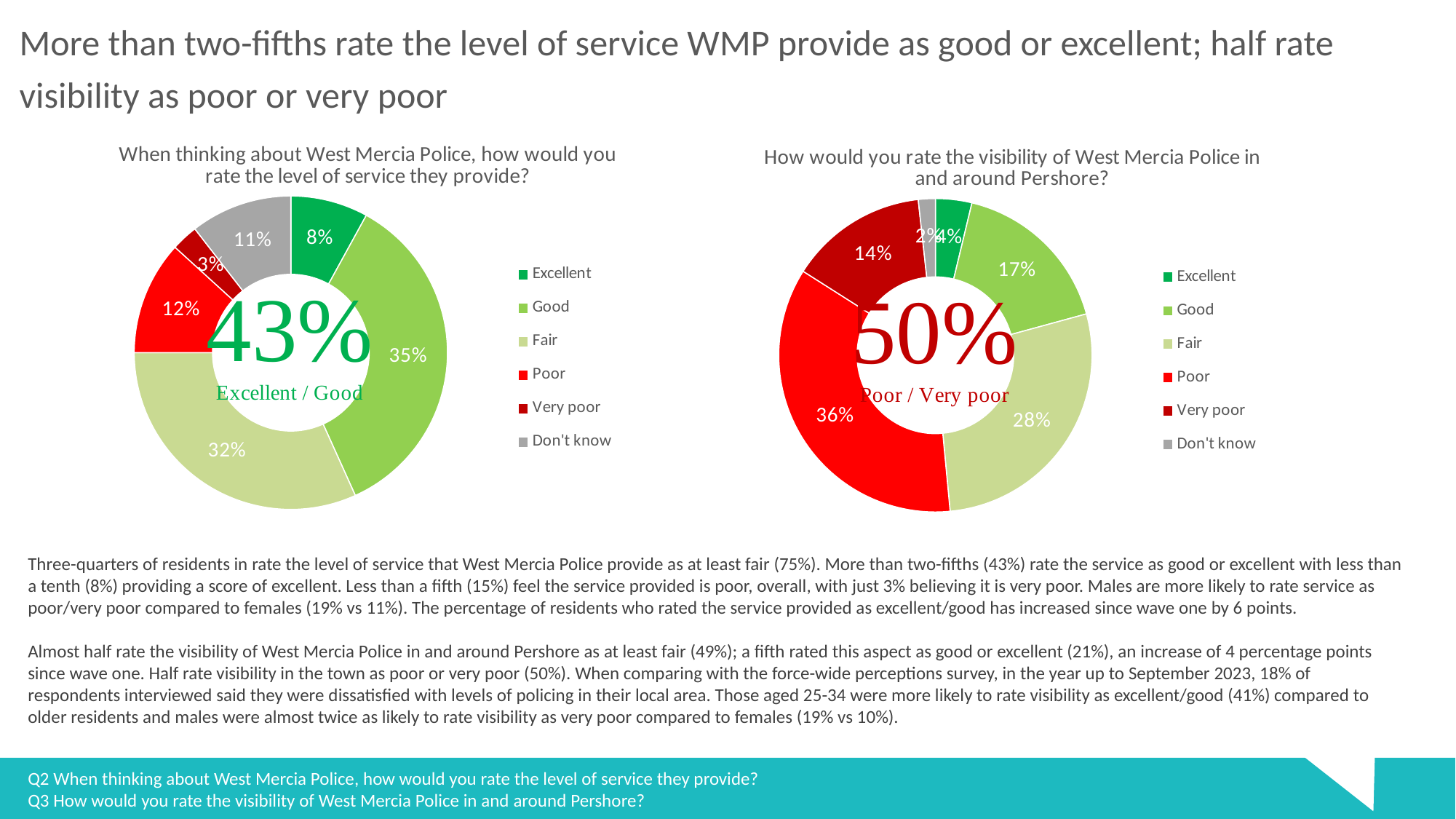
In the chart 'When thinking about West Mercia Police, how would you rate the level of service they provide?', what percentage rated the service as Fair? 32% How many categories does the legend list for the chart 'How would you rate the visibility of West Mercia Police in and around Pershore?' 6 In the chart 'How would you rate the visibility of West Mercia Police in and around Pershore?', what percentage rated visibility as Very poor? 14% What type of chart is used on the left of the slide to show ratings of the level of service? Pie chart (donut) In the chart 'How would you rate the visibility of West Mercia Police in and around Pershore?', what percentage rated visibility as Fair? 28% In the chart 'How would you rate the visibility of West Mercia Police in and around Pershore?', what percentage rated visibility as Poor? 36% In the chart 'When thinking about West Mercia Police, how would you rate the level of service they provide?', what percentage answered Don't know? 11% In the chart 'When thinking about West Mercia Police, how would you rate the level of service they provide?', which category has the largest share? Good In the chart 'When thinking about West Mercia Police, how would you rate the level of service they provide?', which category has the smallest share? Very poor In the chart 'When thinking about West Mercia Police, how would you rate the level of service they provide?', what percentage rated the service as Good? 35% In the chart 'How would you rate the visibility of West Mercia Police in and around Pershore?', which is larger, the Good share or the Fair share? Fair In the chart 'When thinking about West Mercia Police, how would you rate the level of service they provide?', what is the difference between the Poor and Very poor percentages? 9%